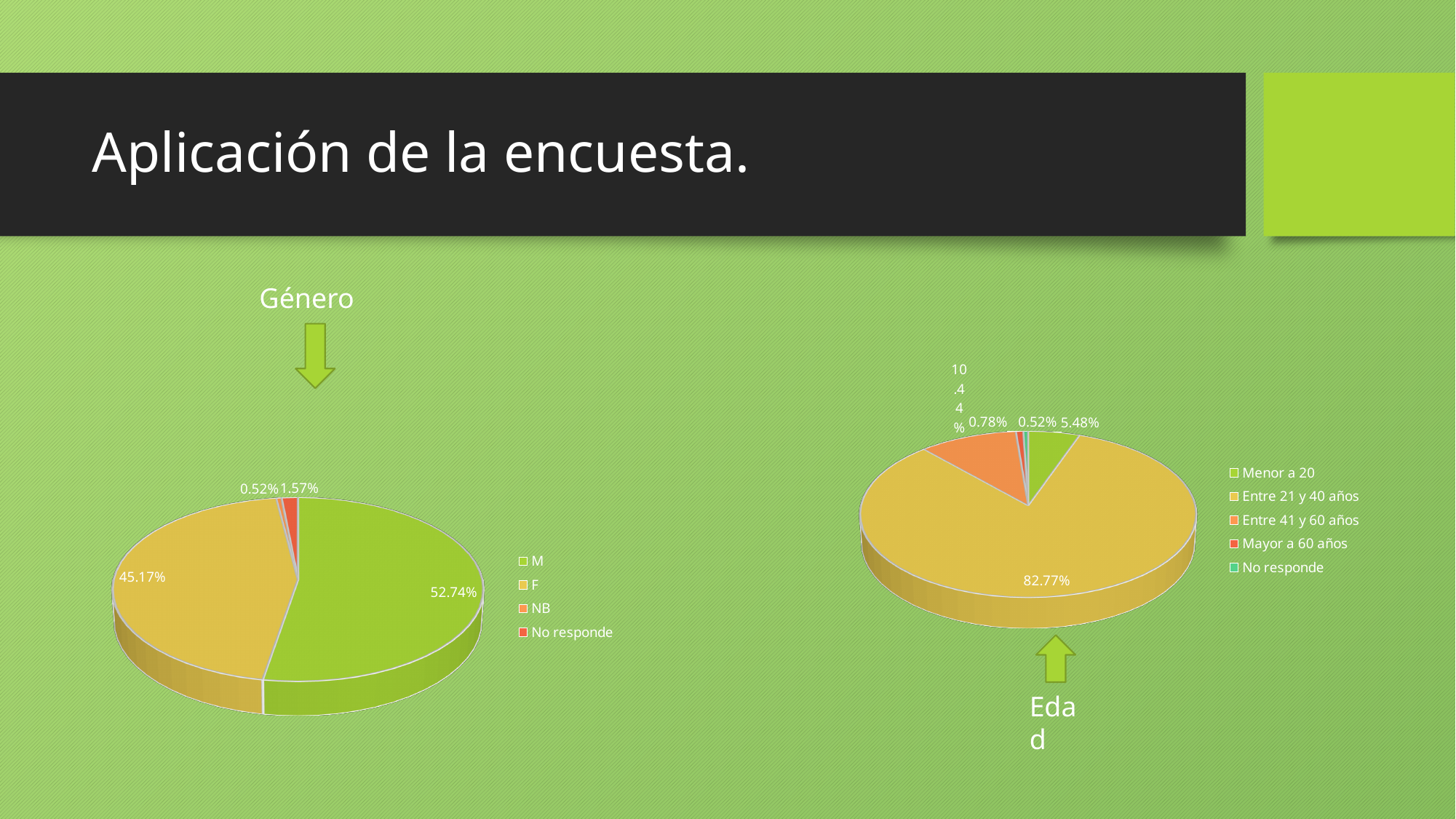
What type of chart is the Edad chart? Pie chart How many categories does the legend of the Género chart list? 4 In the Edad pie chart, which category has the largest share? Entre 21 y 40 años In the Género pie chart, which category has the largest share? M In the Edad pie chart, which is larger: Menor a 20 or Entre 41 y 60 años? Entre 41 y 60 años In the Género pie chart, what percentage is shown for M? 52.74% How many categories does the legend of the Edad chart list? 5 In the Edad pie chart, what percentage is shown for Entre 21 y 40 años? 82.77% In the Edad pie chart, what percentage is shown for Entre 41 y 60 años? 10.44% In the Edad pie chart, what percentage is shown for Menor a 20? 5.48% In the Género pie chart, what is the difference between the M and F shares? 7.57% In the Género pie chart, what percentage is shown for F? 45.17%